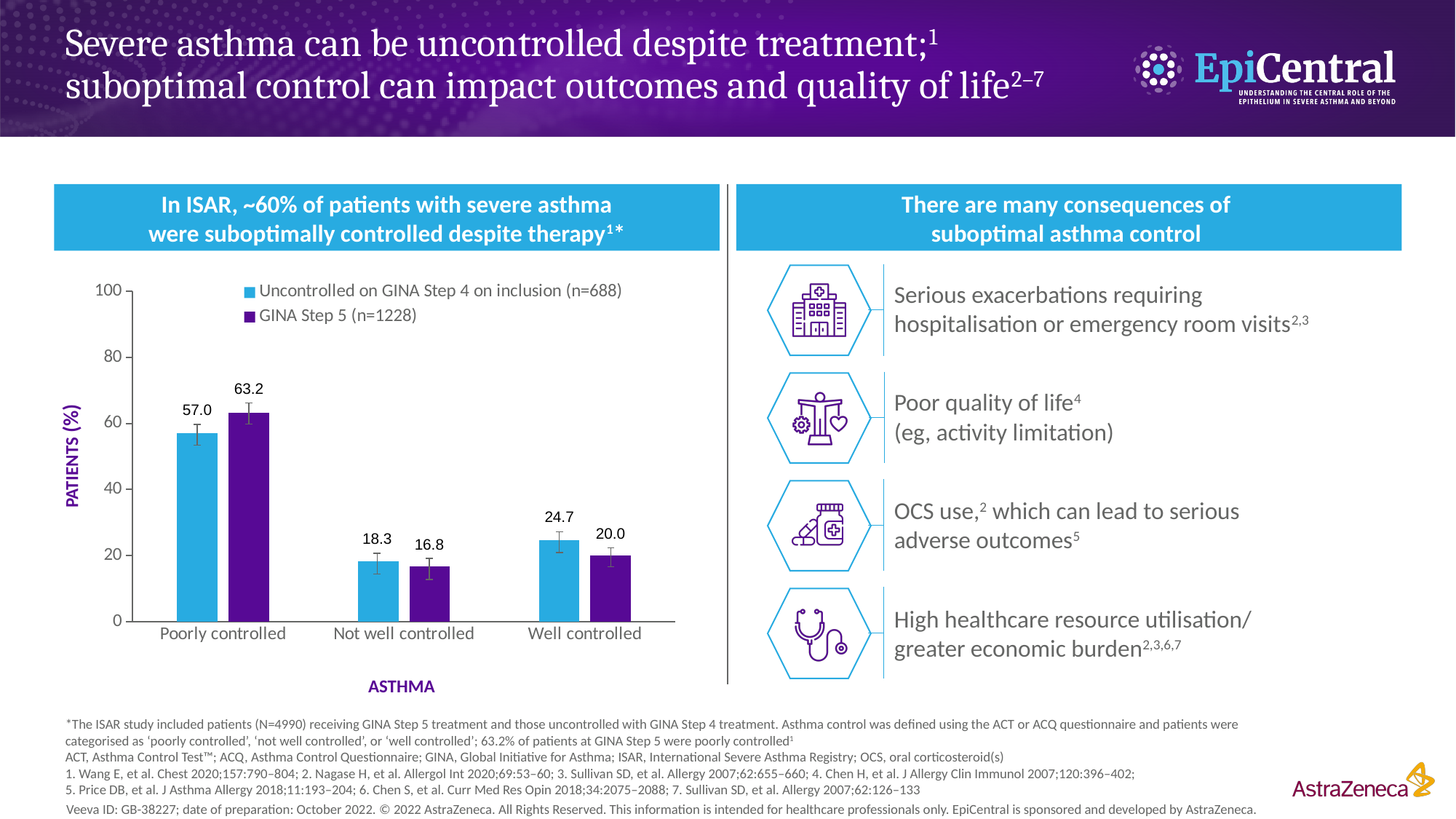
Which asthma control category has the lowest value for the 'Uncontrolled on GINA Step 4 on inclusion' series? Not well controlled What percentage of GINA Step 5 patients were poorly controlled? 63.2 What is the value for GINA Step 5 in the 'Not well controlled' category? 16.8 How many series does the legend list? 2 Which asthma control category has the highest value for the GINA Step 5 series? Poorly controlled What is the value for 'Uncontrolled on GINA Step 4 on inclusion' in the 'Well controlled' category? 24.7 How many asthma control categories are shown on the x axis? 3 What is the difference between the GINA Step 5 and GINA Step 4 values in the 'Poorly controlled' category? 6.2 In the 'Well controlled' category, which series has the larger value: 'Uncontrolled on GINA Step 4 on inclusion' or 'GINA Step 5'? Uncontrolled on GINA Step 4 on inclusion What is the label of the y axis of the chart? PATIENTS (%) What type of chart is shown on the slide? Bar chart What percentage of patients uncontrolled on GINA Step 4 on inclusion were poorly controlled? 57.0